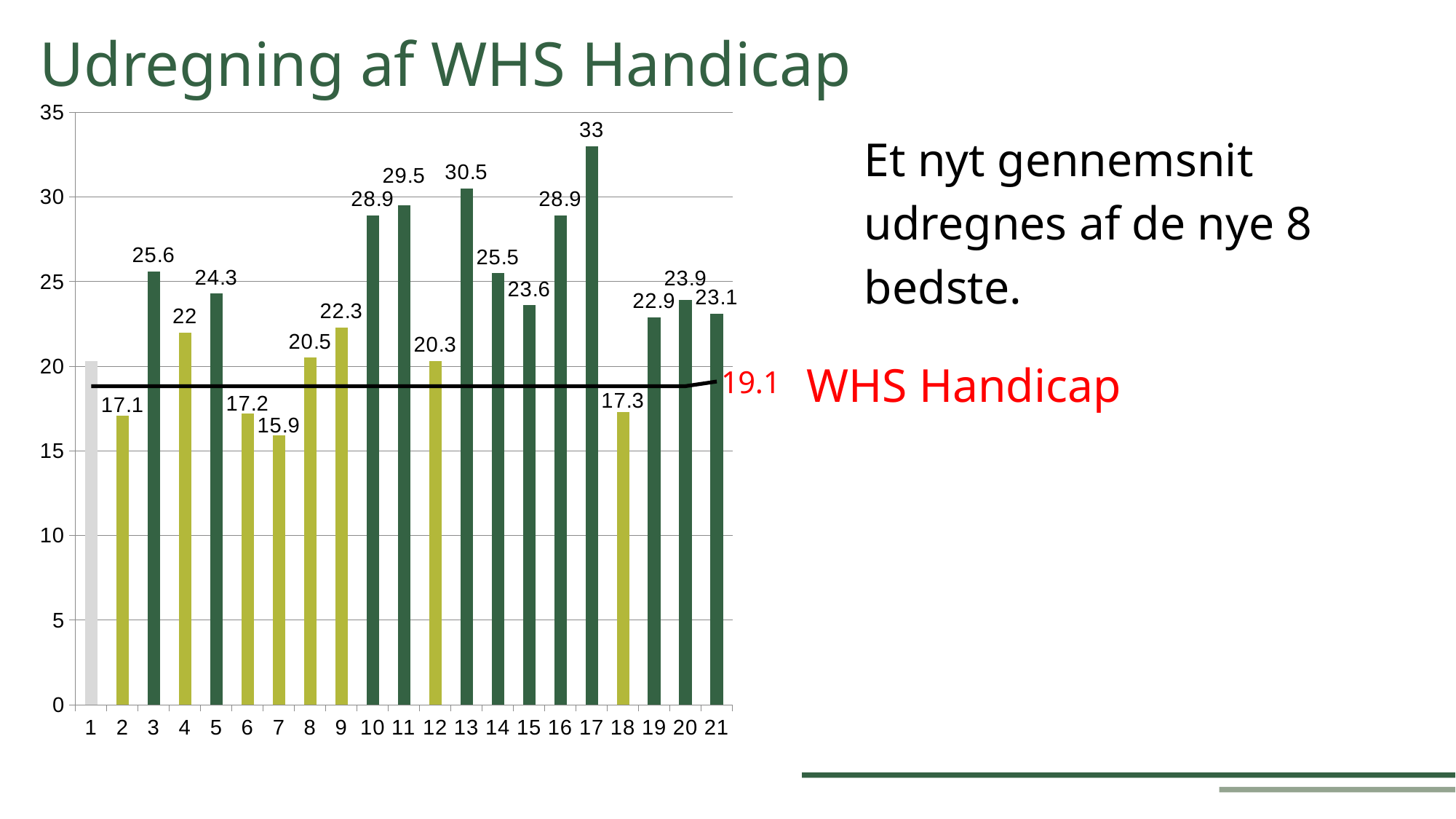
What value is shown for the WHS Handicap line? 19.1 Which category has the highest value? 17 What is the value for category 17? 33 What is the value for category 7? 15.9 What kind of chart is shown on the slide? combination bar and line chart What is the difference between the values for category 17 and category 7? 17.1 Which category has the lowest value? 7 Is the value for category 1 greater or less than 25? less What is the value for category 4? 22 What is the value for category 13? 30.5 Which is larger, the value for category 11 or the value for category 13? 13 How many categories are shown on the x axis? 21